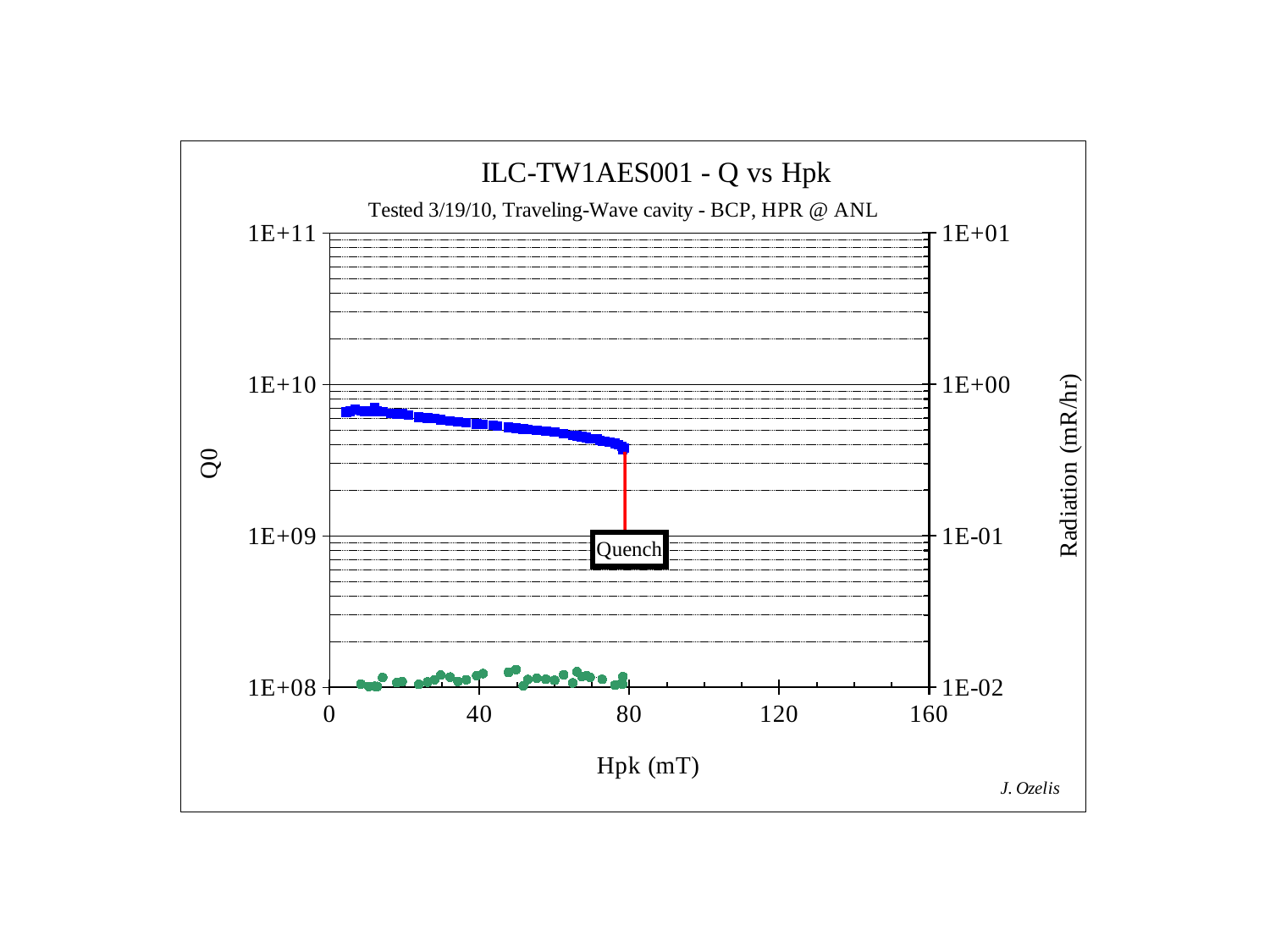
What is the label of the x axis? Hpk (mT) What is the highest tick value shown on the x axis? 160 Is the Q0 value at Hpk = 40 mT greater or less than 1E+10? less What is the title of the chart? ILC-TW1AES001 - Q vs Hpk Is the Hpk value at which the quench occurs greater or less than 40 mT? greater Is the Q0 value at Hpk = 20 mT greater or less than 1E+10? less Is the Q0 value at Hpk = 10 mT greater or less than the Q0 value at Hpk = 70 mT? greater What kind of chart is shown on the slide? scatter chart Does Q0 rise or fall as Hpk increases along the x axis? fall